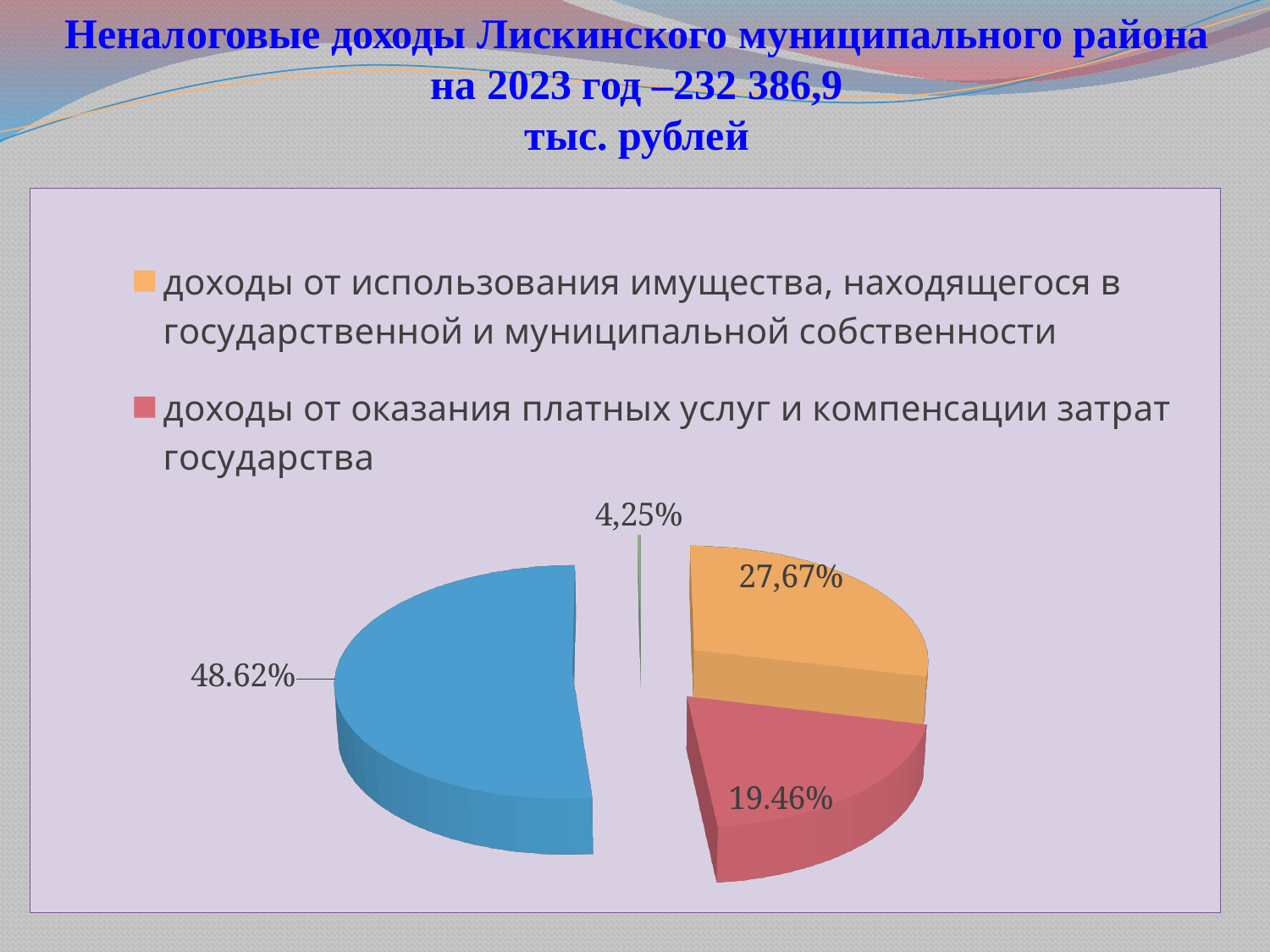
What share of the pie is labelled for 'доходы от оказания платных услуг и компенсации затрат государства'? 19.46% What kind of chart is shown on the slide? pie chart What colour is the slice for 'доходы от оказания платных услуг и компенсации затрат государства'? red Is the share for 'доходы от использования имущества' greater or less than 25%? greater Which slice is larger: 'доходы от использования имущества' or 'доходы от оказания платных услуг и компенсации затрат государства'? доходы от использования имущества What is the largest percentage labelled on the pie chart? 48.62% How many slices does the pie chart have? 4 What share of the pie is labelled for 'доходы от использования имущества, находящегося в государственной и муниципальной собственности'? 27,67% What is the smallest percentage labelled on the pie chart? 4,25% How many entries does the legend list? 2 What total amount of non-tax revenue for 2023 is stated in the slide title? 232 386,9 тыс. рублей Is the share for 'доходы от оказания платных услуг и компенсации затрат государства' greater or less than 20%? less